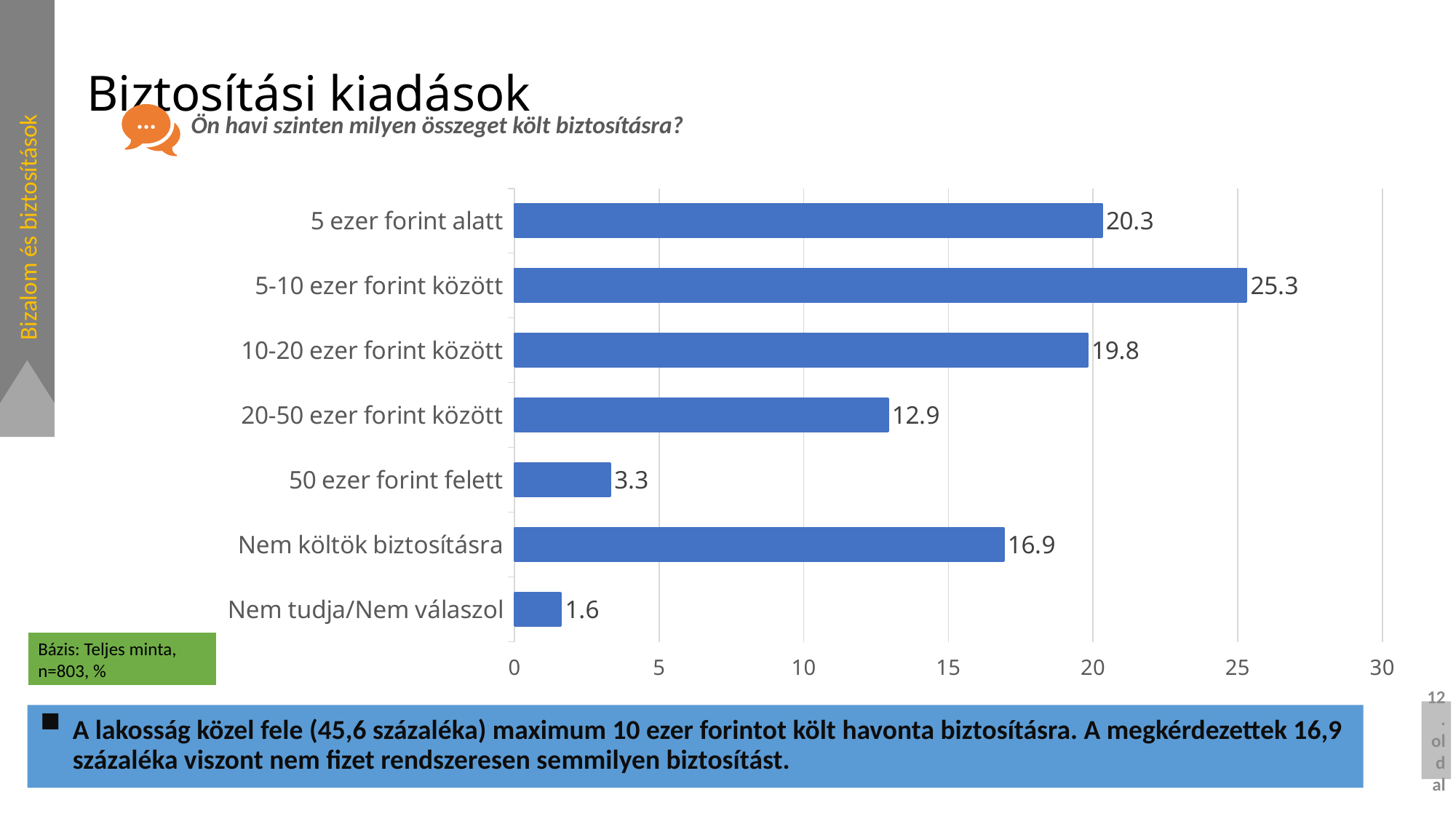
What is the value for "50 ezer forint felett"? 3.3 How many categories are shown in the chart? 7 What is the value for "Nem költök biztosításra"? 16.9 Which category has the highest value? 5-10 ezer forint között What is the total of the values for "5 ezer forint alatt" and "5-10 ezer forint között"? 45.6 What kind of chart is shown on the slide? Bar chart Which category has the lowest value? Nem tudja/Nem válaszol What is the value for "5-10 ezer forint között"? 25.3 What is the maximum value shown on the horizontal axis? 30 What is the difference between the values for "5 ezer forint alatt" and "10-20 ezer forint között"? 0.5 Which is larger, the value for "20-50 ezer forint között" or the value for "Nem költök biztosításra"? Nem költök biztosításra Is the value for "10-20 ezer forint között" greater or less than 15? greater